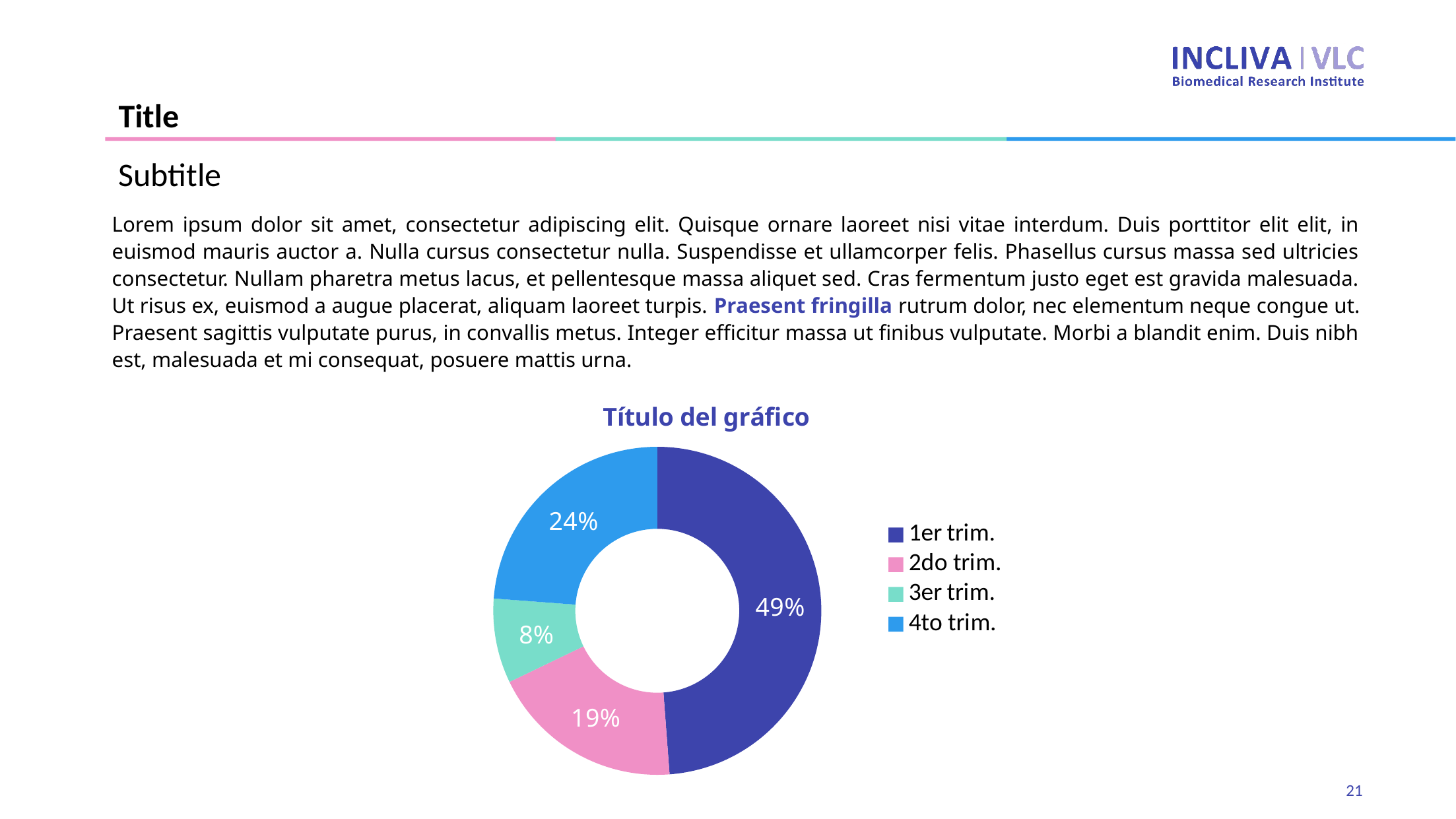
What share of the doughnut chart does 2do trim. represent? 19% What is the title of the chart? Título del gráfico Which slice is larger, 2do trim. or 4to trim.? 4to trim. What kind of chart is shown on the slide? Doughnut chart Which colour represents 2do trim. in the chart legend? Pink What share of the doughnut chart does 1er trim. represent? 49% How many categories does the chart show? 4 Which category has the largest slice in the chart? 1er trim. What share of the doughnut chart does 4to trim. represent? 24% What is the difference in percentage points between the 1er trim. and 4to trim. slices? 25 Which category has the smallest slice in the chart? 3er trim.